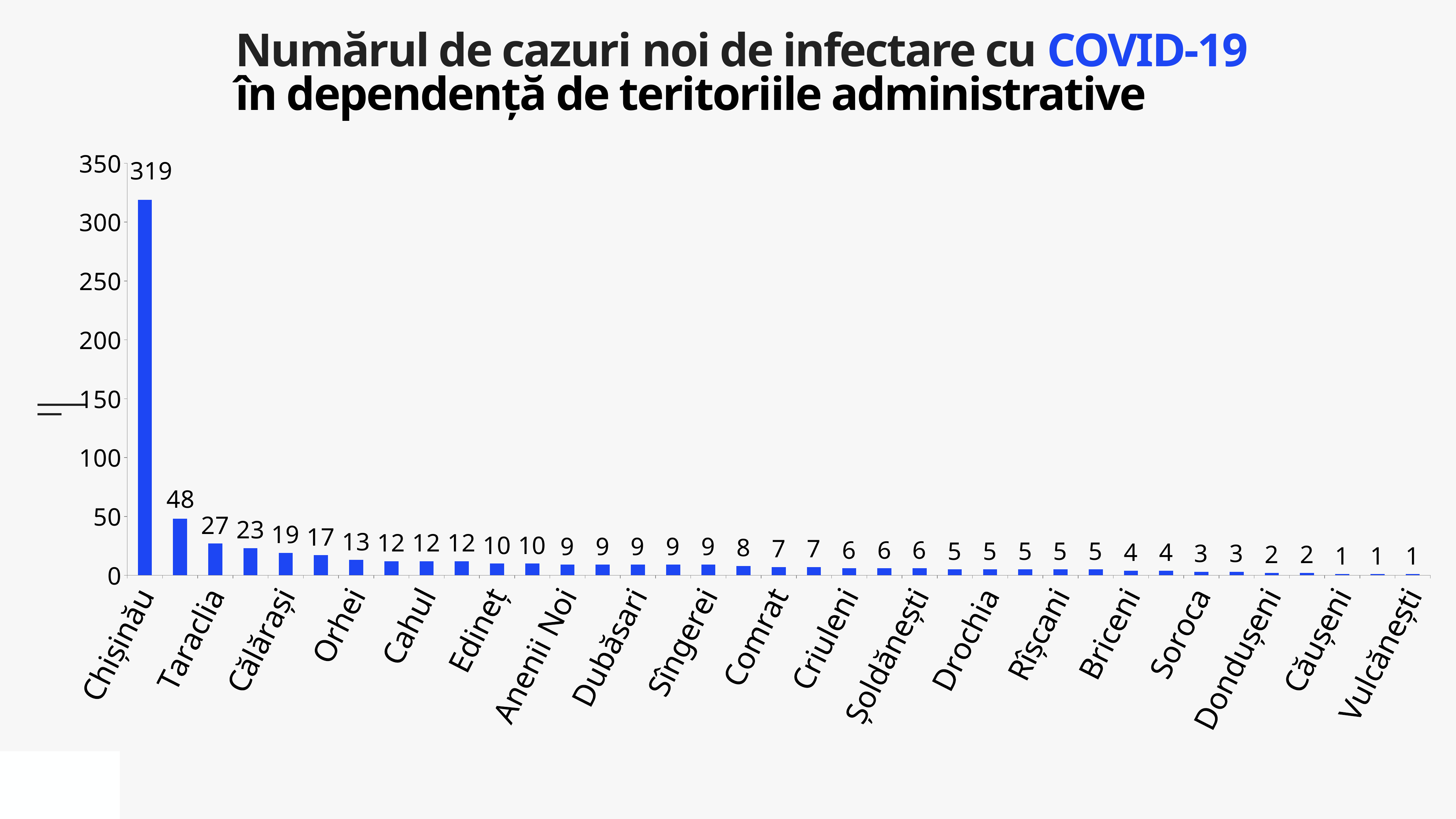
How many bars have a value of 1? 3 What is the value of the second-highest bar in the chart? 48 What kind of chart is shown on the slide? bar chart What is the difference between the highest bar (319) and the second-highest bar (48)? 271 Is the value for Chișinău greater or less than 300? greater Which administrative territory has the highest number of new COVID-19 cases? Chișinău What is the highest tick value shown on the vertical axis? 350 What is the value of the last bar on the right, labelled Vulcănești? 1 Do the bar values rise or fall from left to right along the x axis? fall How many bars are plotted in the chart? 37 Which word in the chart title is printed in blue? COVID-19 What is the number of new cases shown for Chișinău? 319